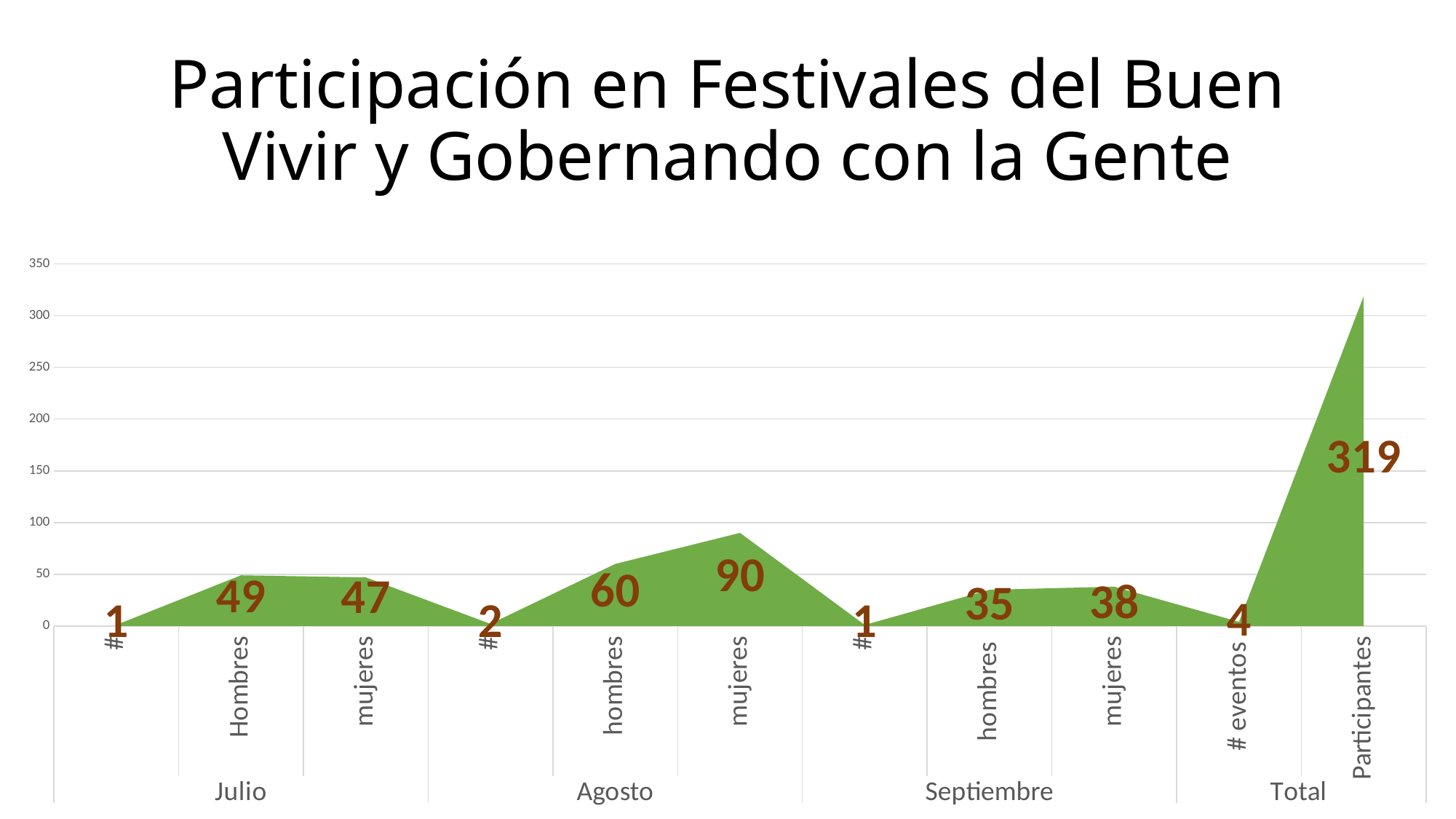
How many month groups are shown on the x axis, including Total? 4 Which is larger, hombres in Septiembre or mujeres in Septiembre? mujeres in Septiembre What is the difference between Hombres and mujeres in Julio? 2 What is the value for Hombres in Julio? 49 What is the value for # eventos under Total? 4 What is the value for mujeres in Agosto? 90 Which category has the highest value? Participantes What is the difference between mujeres and hombres in Agosto? 30 What is the title of the chart on the slide? Participación en Festivales del Buen Vivir y Gobernando con la Gente Is the value for Participantes greater or less than 300? greater What kind of chart is shown on the slide? area chart What is the value for Participantes under Total? 319